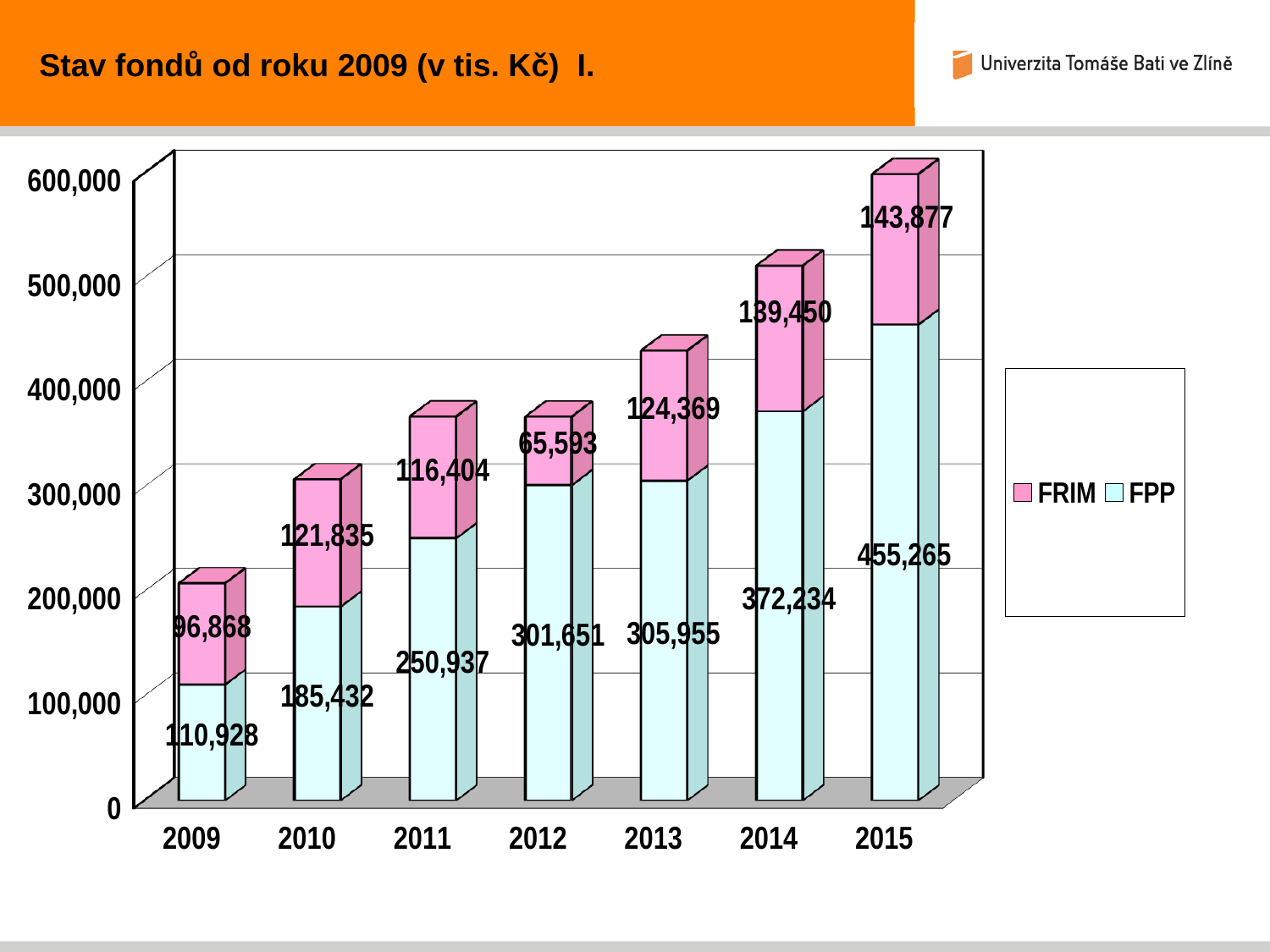
Which is larger, the FRIM value for 2010 or the FRIM value for 2011? 2010 What is the FRIM value for 2013? 124,369 How many series does the legend list? 2 Which year has the lowest FRIM value? 2012 What type of chart is shown on the slide? Stacked bar chart How many years are shown on the x axis? 7 Do the FPP values rise or fall from 2009 to 2015? Rise What is the FPP value for 2011? 250,937 What is the total of the stacked bar for 2009? 207,796 Which year has the highest FPP value? 2015 What is the difference between the FPP values for 2015 and 2009? 344,337 Which series is shown in pink? FRIM